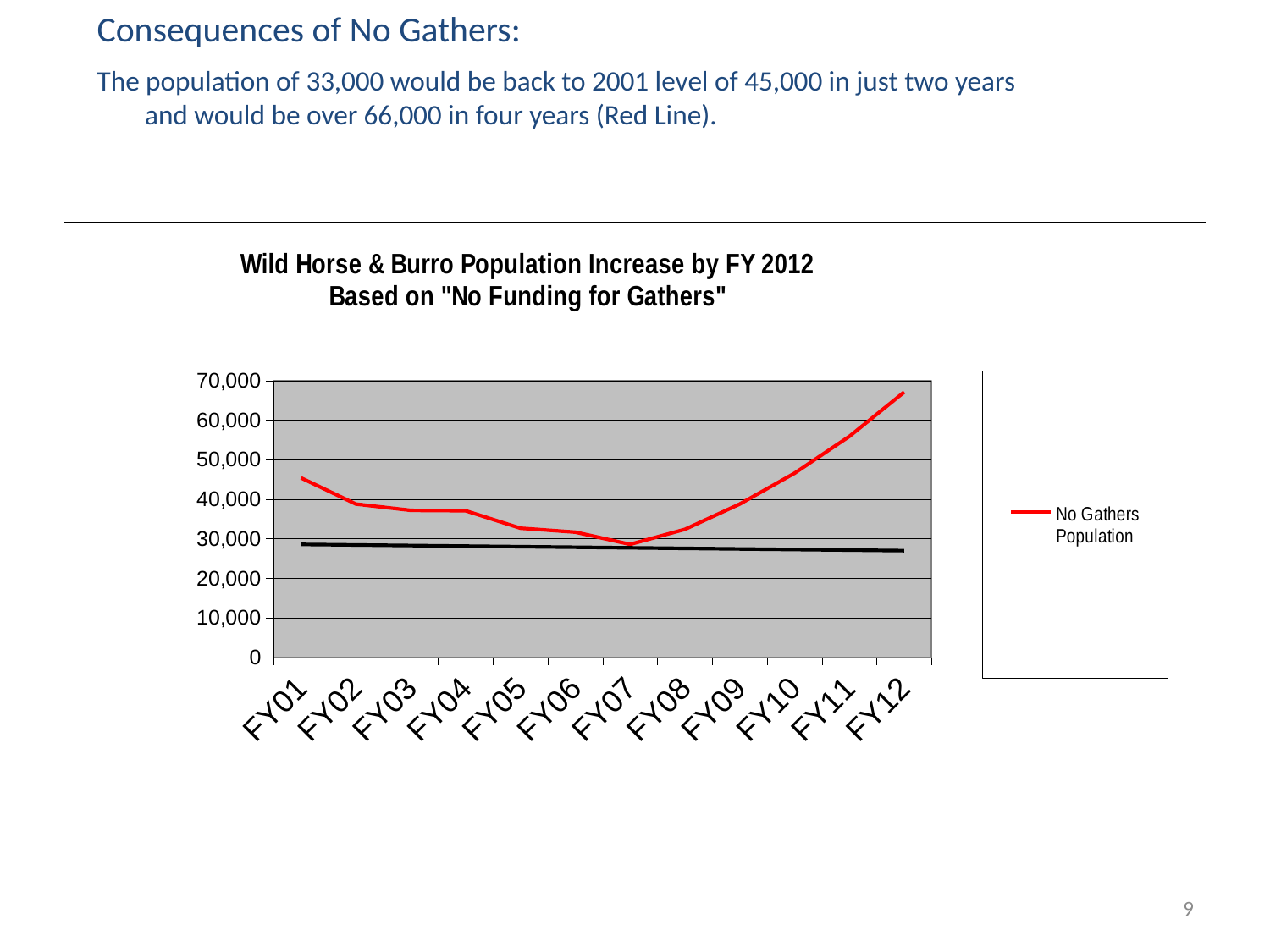
Is the No Gathers Population value for FY01 greater or less than 40,000? greater What colour is the No Gathers Population line in the chart? red How many fiscal years are plotted along the x axis of the chart? 12 Is the No Gathers Population value for FY07 greater or less than 30,000? less In which fiscal year does the No Gathers Population line reach its lowest value? FY07 How many series does the chart's legend list? 1 Is the No Gathers Population value for FY12 greater or less than 60,000? greater Which is larger for the No Gathers Population line: the value for FY01 or the value for FY12? FY12 What is the title of the chart? Wild Horse & Burro Population Increase by FY 2012 Based on "No Funding for Gathers" Does the No Gathers Population line rise or fall from FY07 to FY12? rise In which fiscal year does the No Gathers Population line reach its highest value? FY12 What kind of chart is shown on the slide? line chart